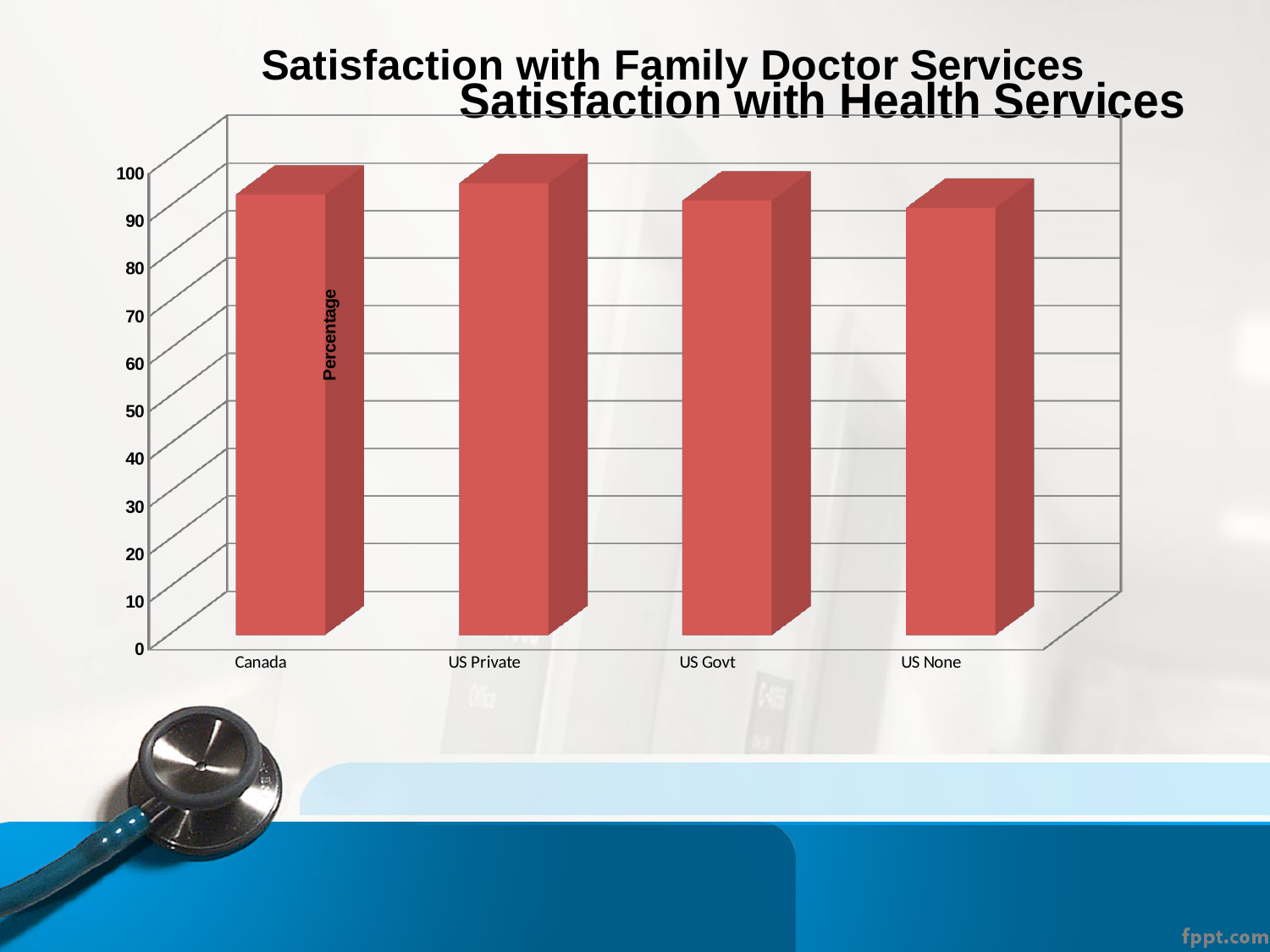
Which category has the highest bar? US Private What is the highest value shown on the vertical axis? 100 Which is larger, the value for US Private or the value for US None? US Private Is the value for US None greater or less than 80? greater What is the label on the vertical axis of the chart? Percentage Is the value for Canada greater or less than 80? greater Is the value for US Private greater or less than 90? greater How many categories are plotted on the chart? 4 What kind of chart is shown on the slide? bar chart